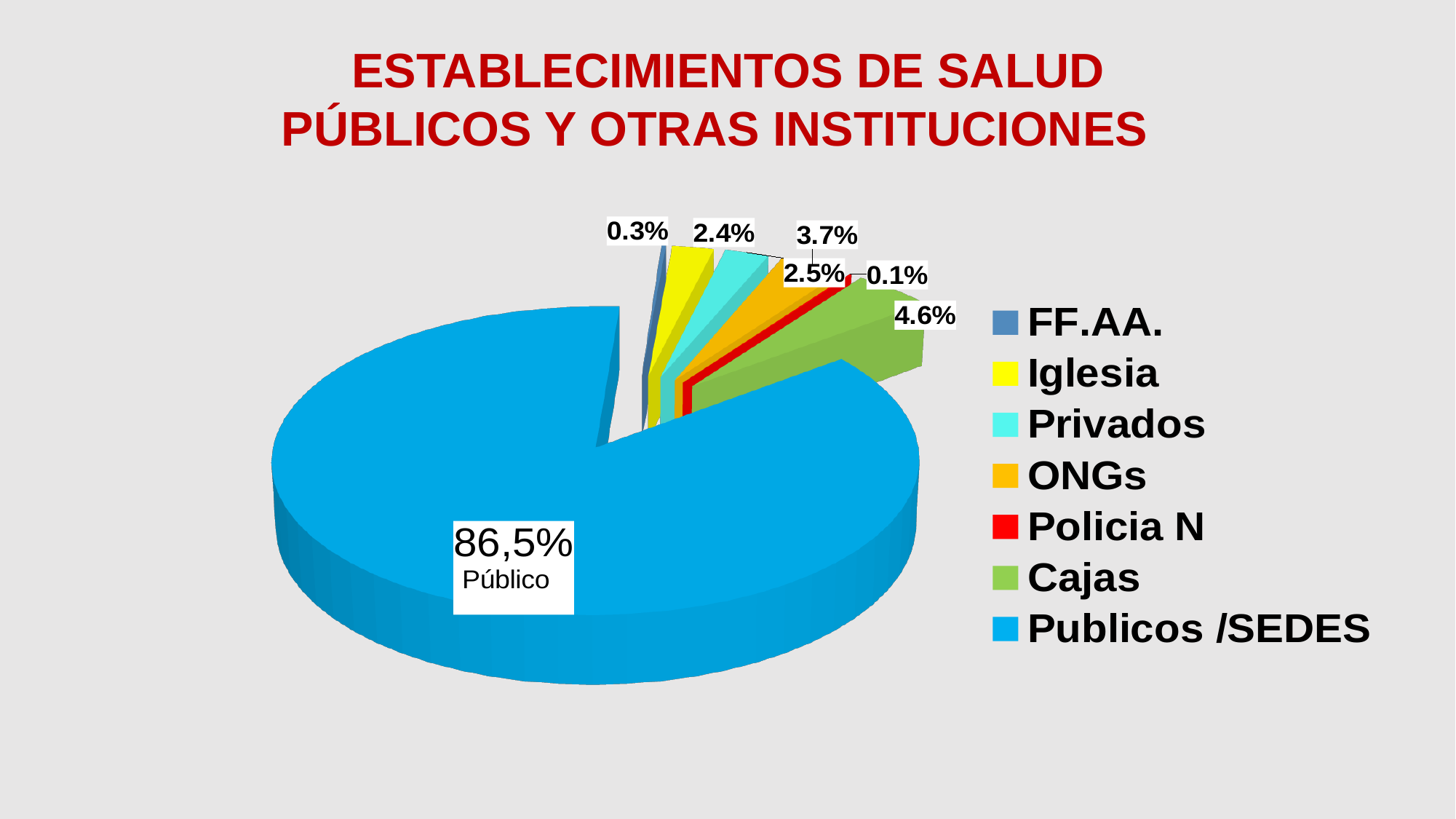
What percentage is shown for the Policia N slice? 0.1% How many categories does the legend of the pie chart list? 7 Which category has the largest share of the pie chart? Publicos /SEDES Which category has the smallest share of the pie chart? Policia N What percentage is shown for the Iglesia slice? 2.4% What percentage is shown for the Publicos /SEDES (Público) slice? 86,5% What kind of chart is shown on the slide? Pie chart What is the difference between the Cajas share and the FF.AA. share? 4.3% What colour represents Cajas in the legend? Green Which slice is larger, Cajas or Iglesia? Cajas What percentage is shown for the FF.AA. slice? 0.3% What percentage is shown for the Cajas slice? 4.6%